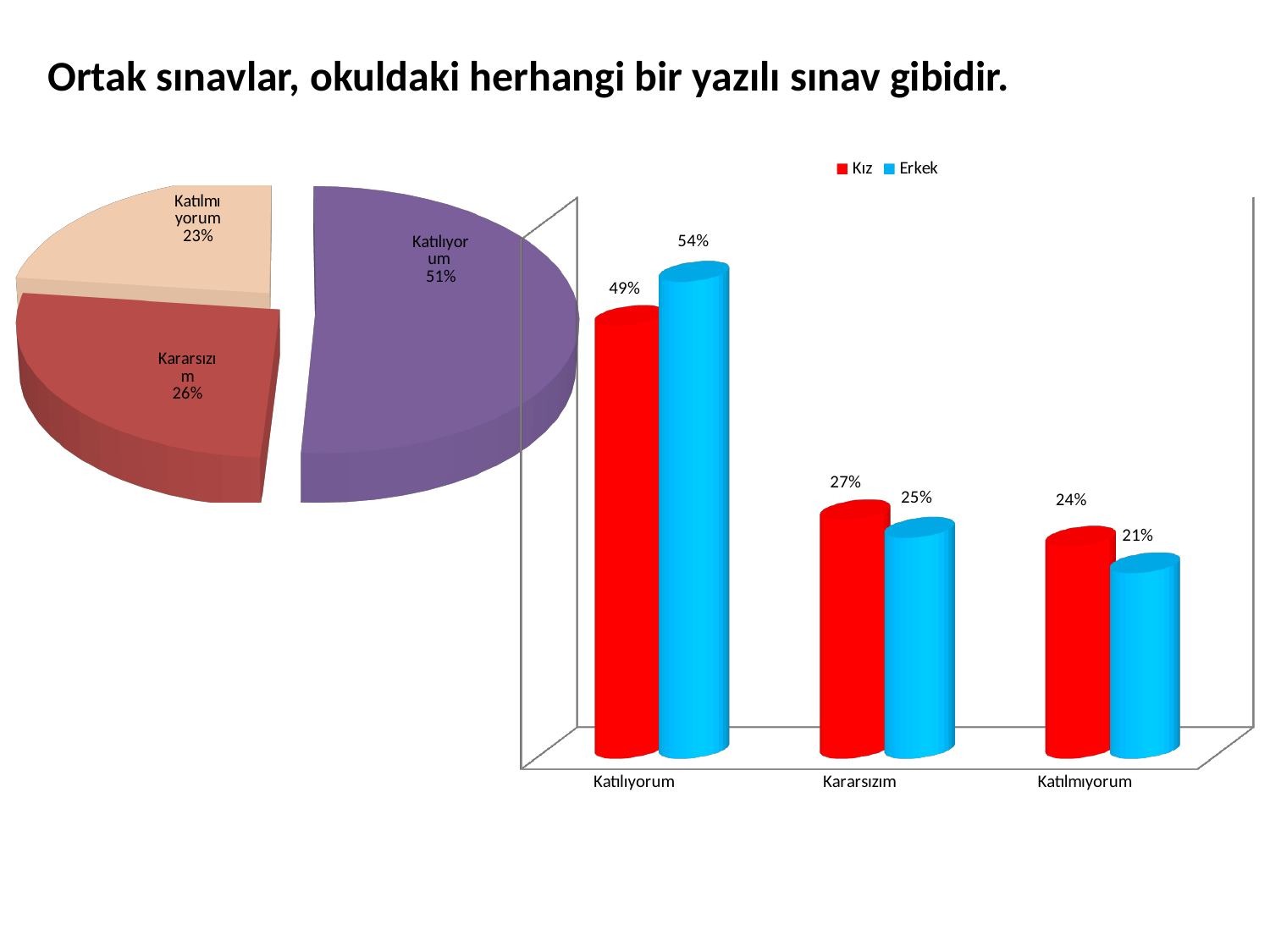
In the bar chart on the right, what is the difference between Erkek and Kız in Katılıyorum? 5% In the bar chart on the right, what is the value for Erkek in Katılıyorum? 54% In the bar chart on the right, what is the value for Erkek in Katılmıyorum? 21% In the bar chart on the right, which is larger for Katılmıyorum, Kız or Erkek? Kız In the pie chart on the left, which slice is the smallest? Katılmıyorum In the pie chart on the left, how many slices are there? 3 In the bar chart on the right, what is the value for Kız in Kararsızım? 27% In the bar chart on the right, how many series does the legend list? 2 In the pie chart on the left, what share does Kararsızım have? 26% What kind of chart is the chart on the right? Bar chart In the bar chart on the right, which category has the highest Kız value? Katılıyorum In the pie chart on the left, what share does Katılıyorum have? 51%